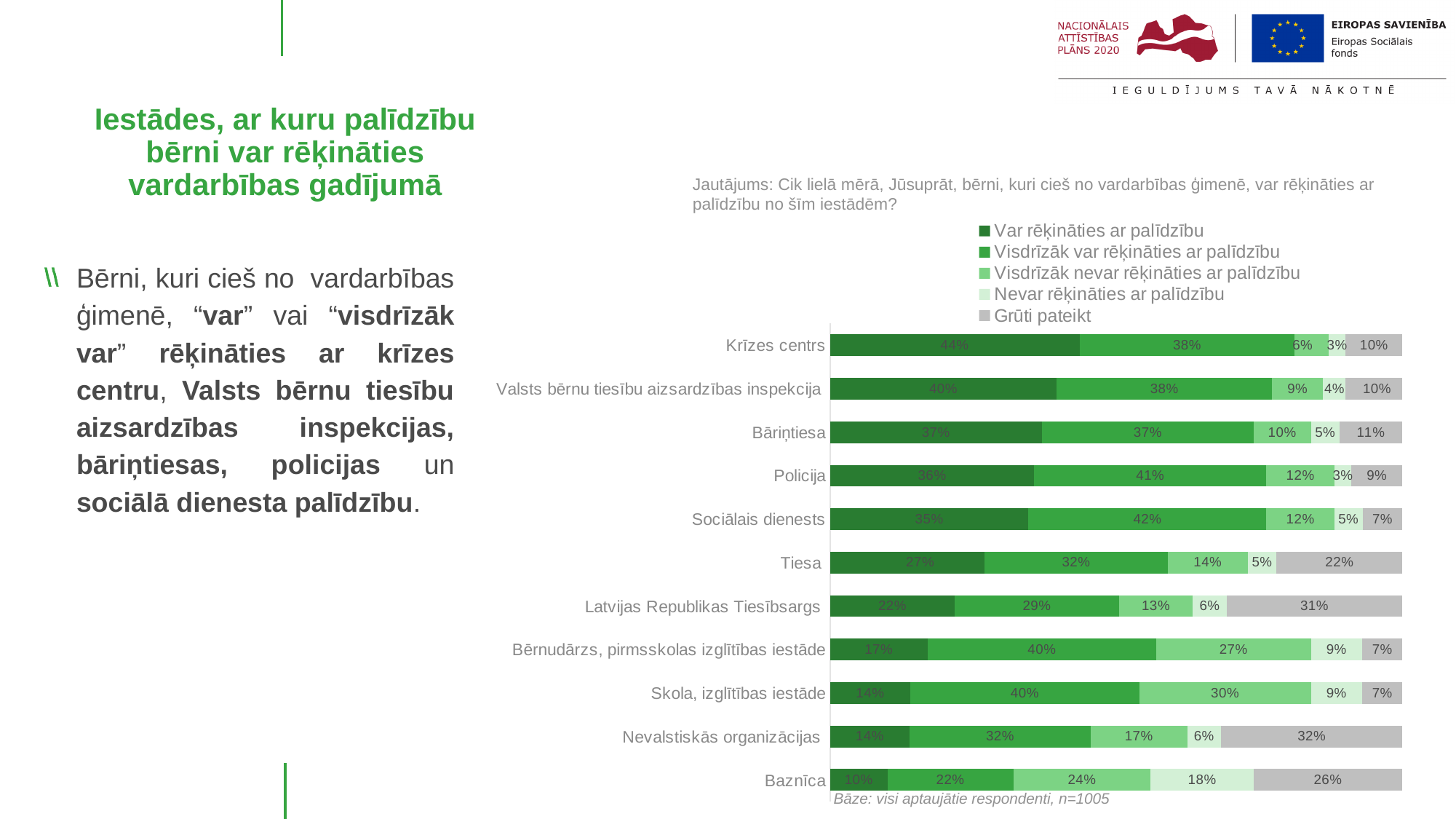
What is the difference between the "Visdrīzāk var rēķināties ar palīdzību" values for Sociālais dienests and Tiesa? 10% What kind of chart is shown on the slide? Stacked bar chart What is the value of "Var rēķināties ar palīdzību" for Krīzes centrs? 44% What base (sample size) is stated below the chart? n=1005 Which has a larger "Grūti pateikt" value, Latvijas Republikas Tiesībsargs or Tiesa? Latvijas Republikas Tiesībsargs How many series does the legend list? 5 What is the value of "Nevar rēķināties ar palīdzību" for Baznīca? 18% Which institution has the highest value for "Var rēķināties ar palīdzību"? Krīzes centrs What is the value of "Grūti pateikt" for Nevalstiskās organizācijas? 32% What is the combined value of "Var rēķināties ar palīdzību" and "Visdrīzāk var rēķināties ar palīdzību" for Policija? 77% Which institution has the lowest value for "Var rēķināties ar palīdzību"? Baznīca How many institutions (categories) are shown in the chart? 11